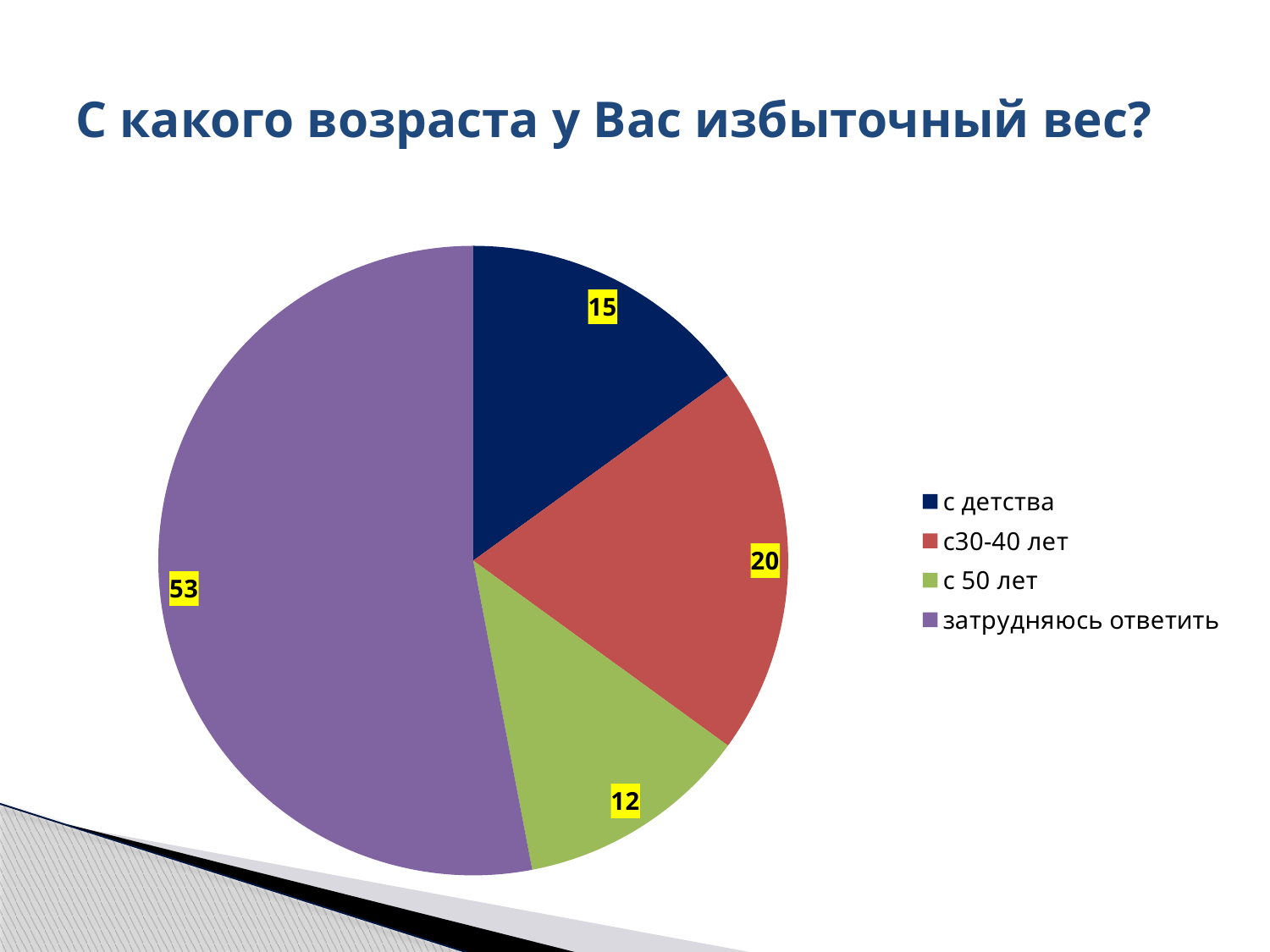
What is the value for "с30-40 лет"? 20 What is the difference between the values for "затрудняюсь ответить" and "с30-40 лет"? 33 What is the value for "с детства"? 15 Which category has the smallest slice? с 50 лет What is the total of all the slice values? 100 What is the title of the chart? С какого возраста у Вас избыточный вес? What type of chart is shown on the slide? pie chart Which is larger, the value for "с детства" or the value for "с 50 лет"? с детства What is the value for "с 50 лет"? 12 How many categories does the pie chart have? 4 What is the value for "затрудняюсь ответить"? 53 Which category has the largest slice? затрудняюсь ответить